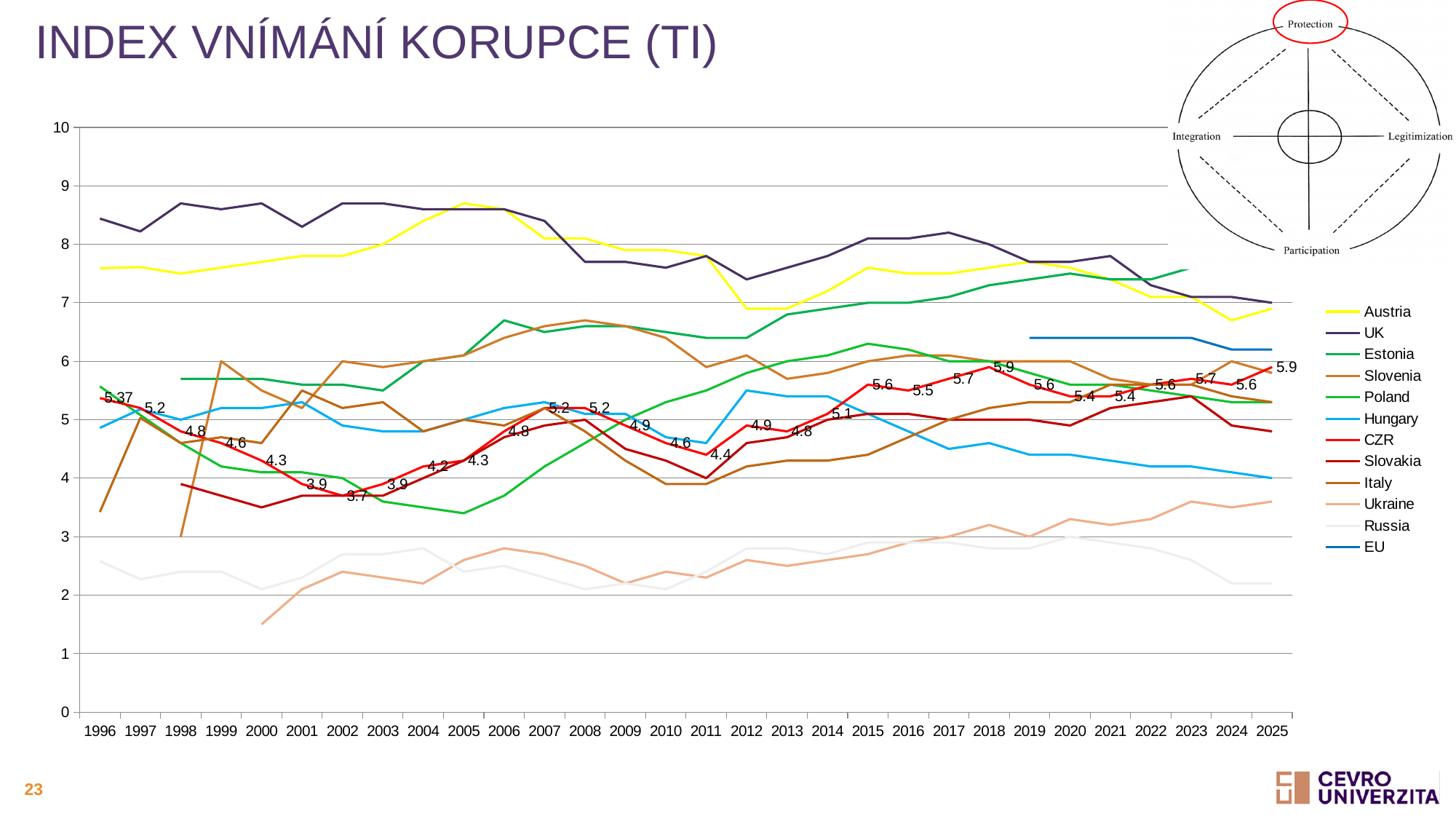
How many years are shown on the x axis? 30 Which is larger, the CZR value in 2018 or the CZR value in 2011? 2018 What is the difference between the CZR value in 2025 and the CZR value in 2002? 2.2 How many series does the legend list? 12 What kind of chart is shown on the slide? line chart Is the value for UK in 1996 greater or less than 8? greater Which series has the highest value in 1996? UK What is the value for CZR in 1996? 5.37 Is the value for Ukraine in 2000 greater or less than 2? less Does the Hungary line rise or fall from 2012 to 2025? fall In which year does the CZR line reach its lowest value? 2002 What is the value for CZR in 2025? 5.9